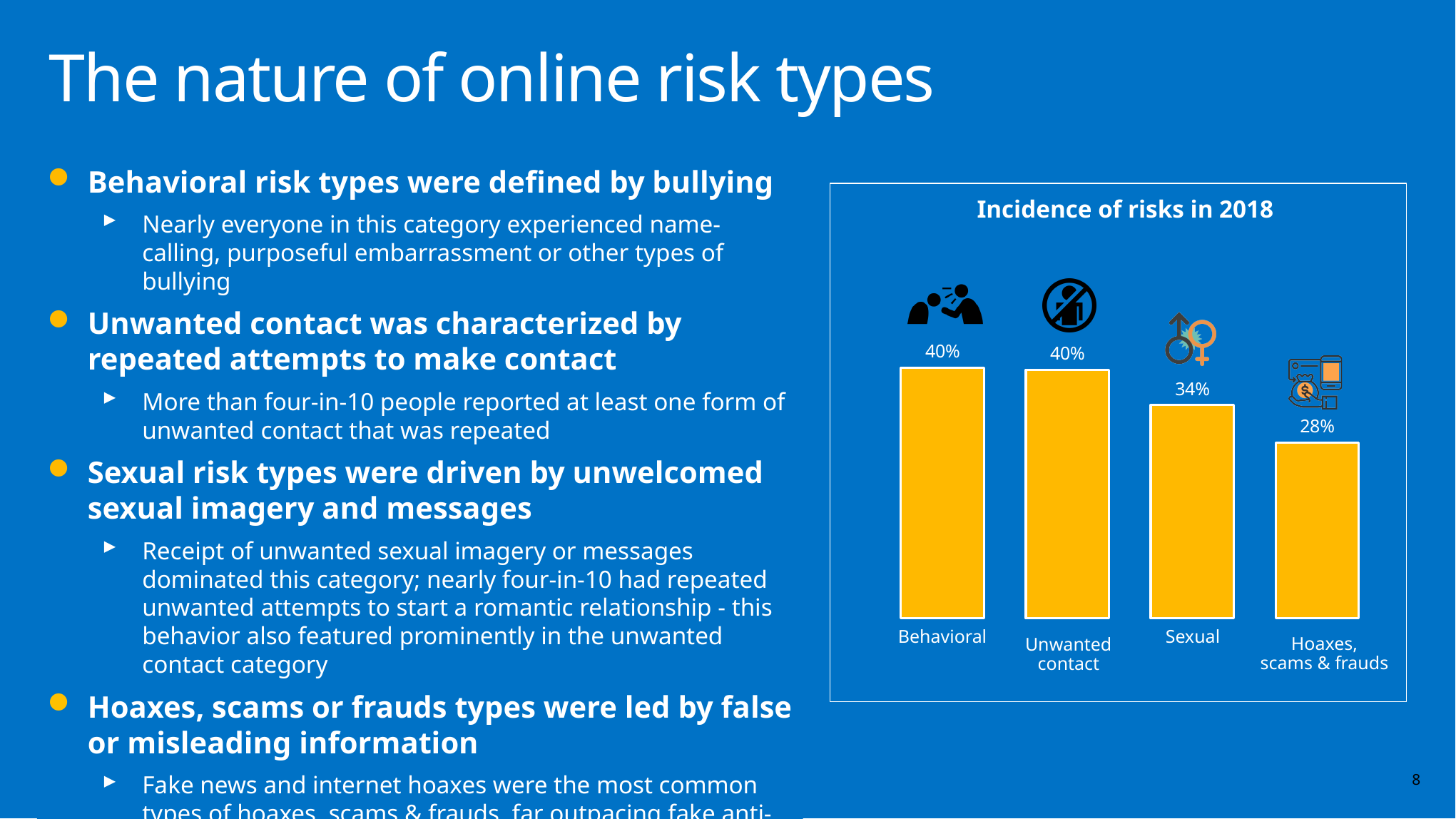
What is the value for Hoaxes, scams & frauds in the chart? 28% What is the difference between the values for Sexual and Hoaxes, scams & frauds? 6% What is the difference between the values for Behavioral and Sexual? 6% What is the title of the chart on the slide? Incidence of risks in 2018 What is the value for Behavioral in the Incidence of risks in 2018 chart? 40% How many categories are shown in the chart? 4 Which is larger, the value for Unwanted contact or the value for Sexual? Unwanted contact Which is larger, the value for Sexual or the value for Hoaxes, scams & frauds? Sexual What is the value for Sexual in the chart? 34% What kind of chart is shown on the slide? Bar chart What is the value for Unwanted contact in the chart? 40% Which category has the lowest value in the chart? Hoaxes, scams & frauds